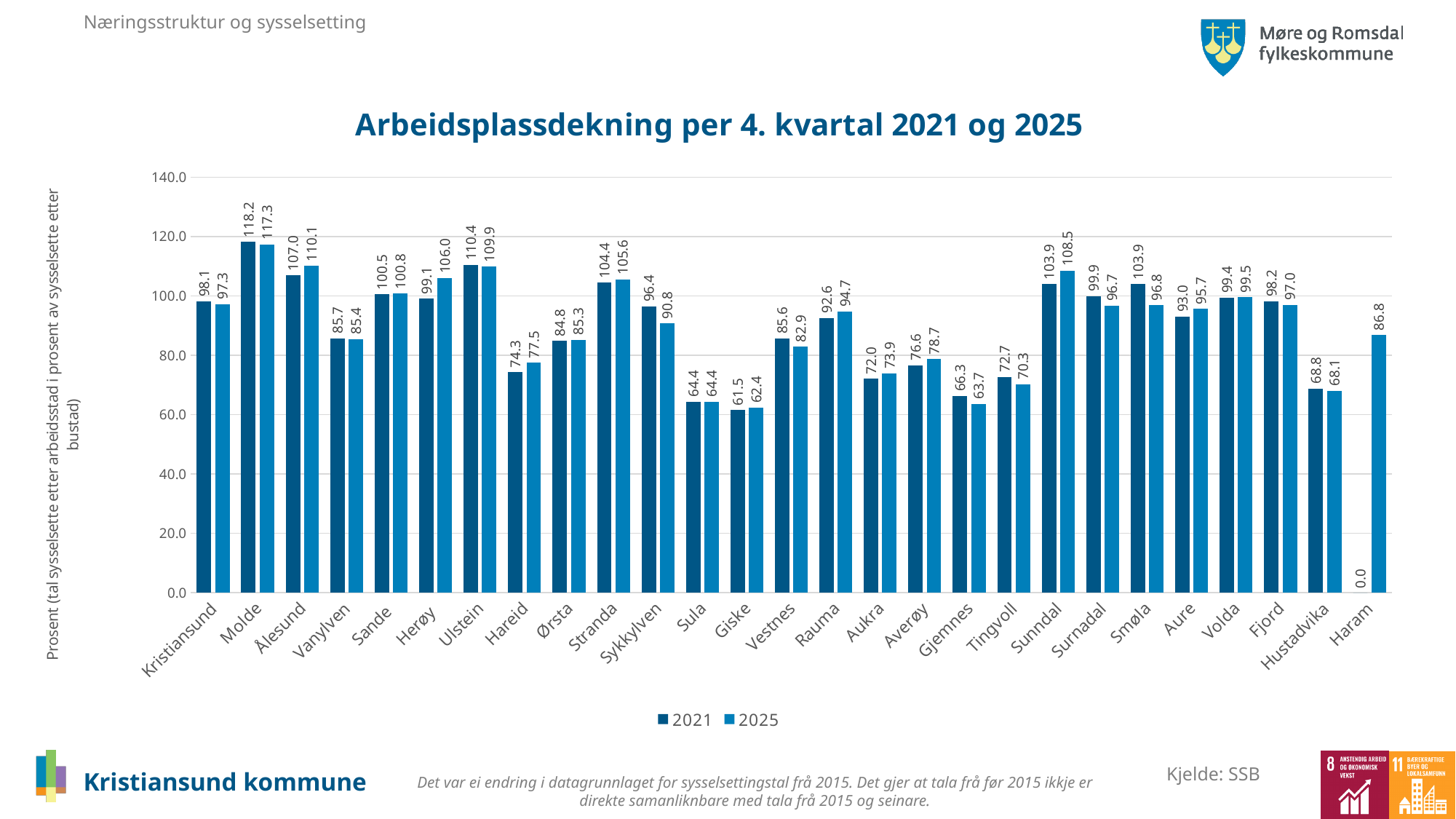
What is the difference between the 2021 and 2025 values for Sykkylven? 5.6 Which is larger for Smøla: the 2021 value or the 2025 value? 2021 How many series does the legend list? 2 What is the value for Sunndal in the 2025 series? 108.5 What is the value for Molde in the 2021 series? 118.2 What is the difference between the 2025 and 2021 values for Herøy? 6.9 Which municipality has the lowest value in the 2025 series? Giske Which municipality has the highest value in the 2025 series? Molde Is the 2025 value for Hareid greater or less than 80.0? less What is the value for Haram in the 2021 series? 0.0 What kind of chart is shown on the slide? bar chart How many municipalities are shown on the x axis? 27